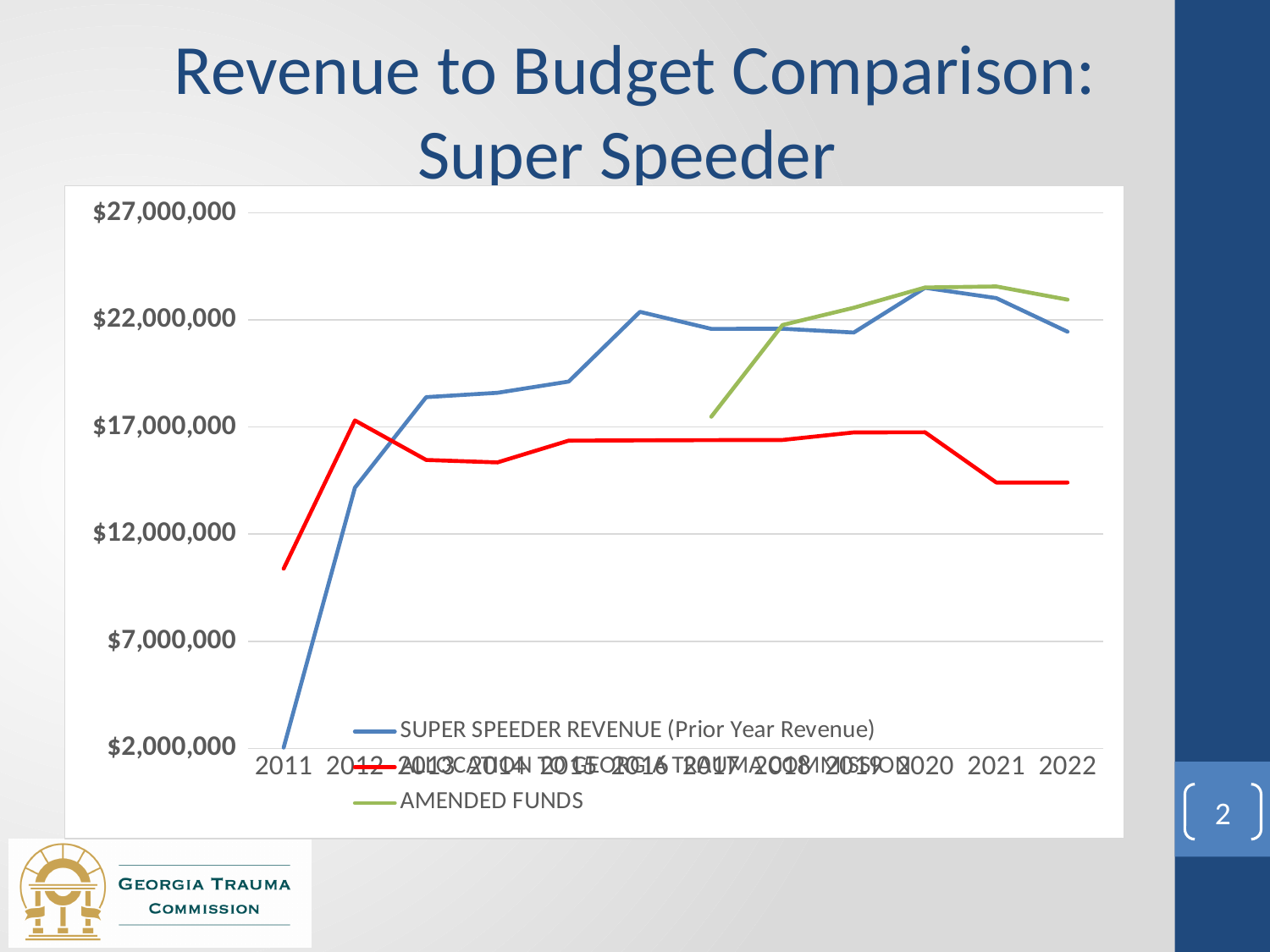
What is the title of the chart slide? Revenue to Budget Comparison: Super Speeder Which year has the lowest SUPER SPEEDER REVENUE (Prior Year Revenue) value? 2011 Is the SUPER SPEEDER REVENUE (Prior Year Revenue) value for 2016 greater or less than $17,000,000? greater Is the SUPER SPEEDER REVENUE (Prior Year Revenue) value for 2013 greater or less than $17,000,000? greater Is the AMENDED FUNDS value for 2020 greater or less than $22,000,000? greater What kind of chart is shown on the slide? line chart In 2022, which is larger: SUPER SPEEDER REVENUE (Prior Year Revenue) or AMENDED FUNDS? AMENDED FUNDS How many series does the chart's legend list? 3 Does SUPER SPEEDER REVENUE (Prior Year Revenue) rise or fall from 2011 to 2016? rise How many years are shown on the x axis of the chart? 12